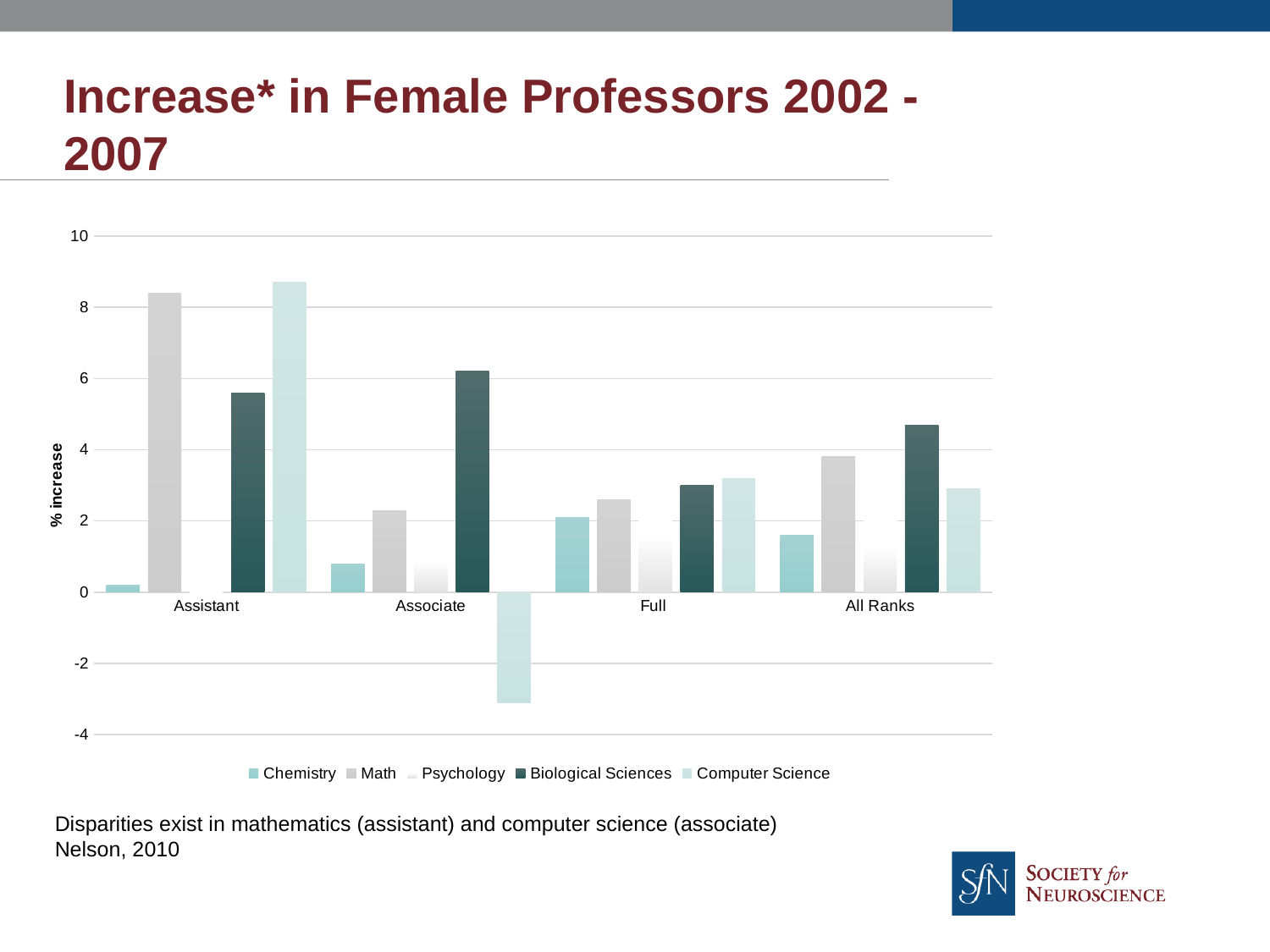
In the Associate category, which series has the highest value? Biological Sciences In the Associate category, which series has the lowest value? Computer Science Is the value for Computer Science in the Associate category greater or less than -2? less How many series does the legend list? 5 What kind of chart is shown on the slide? bar chart In the Assistant category, which is larger: Math or Biological Sciences? Math Is the value for Math in the Assistant category greater or less than 8? greater In the All Ranks category, which series has the highest value? Biological Sciences Is the value for Biological Sciences in the Associate category greater or less than 4? greater What is the label on the y axis? % increase How many rank categories are shown on the x axis? 4